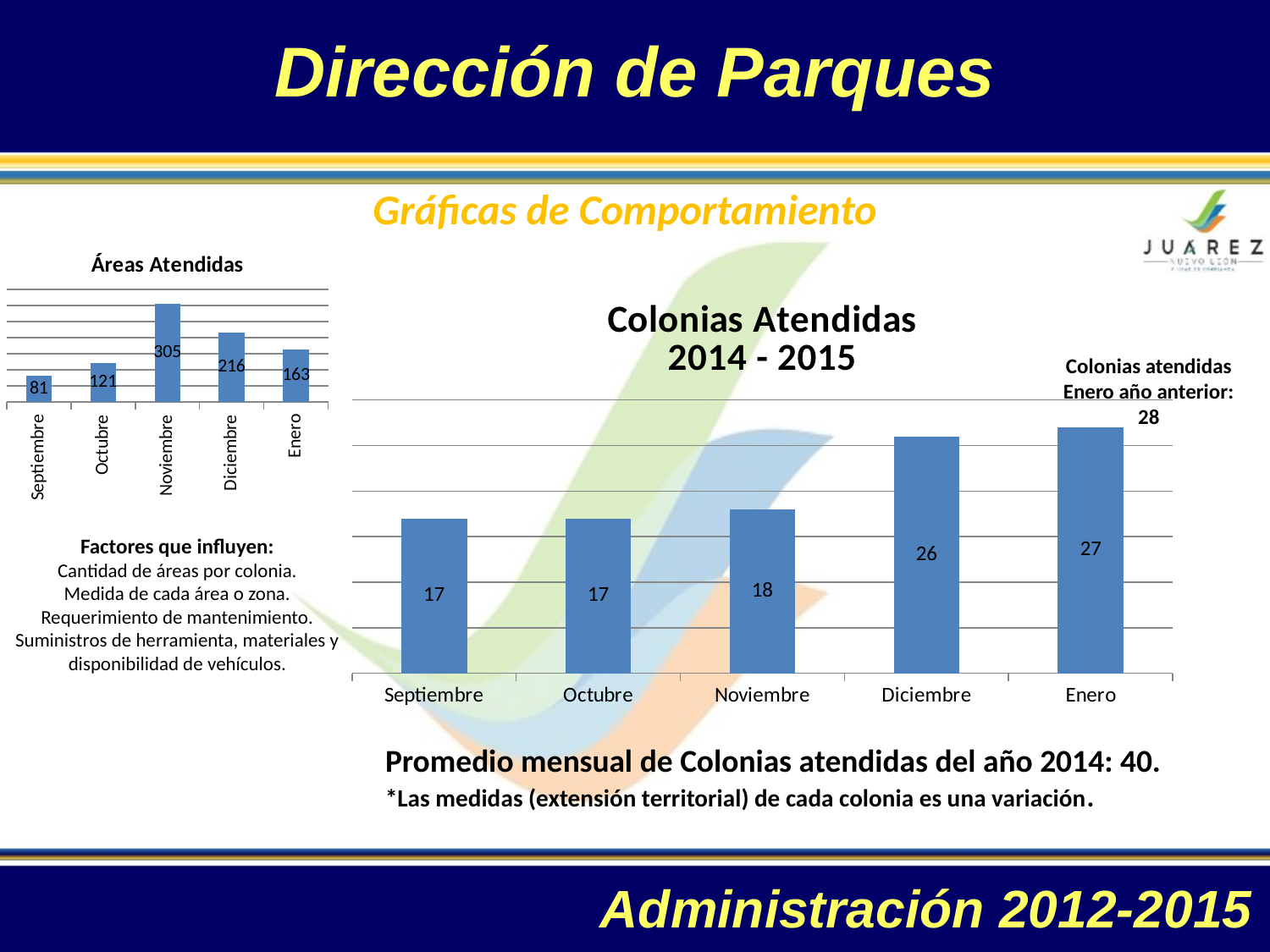
What kind of chart is 'Colonias Atendidas 2014 - 2015'? bar chart In the 'Áreas Atendidas' chart, which is larger, the value for Diciembre or the value for Enero? Diciembre In the 'Colonias Atendidas 2014 - 2015' chart, how many months are shown on the x axis? 5 In the 'Colonias Atendidas 2014 - 2015' chart, do the values generally rise or fall from Septiembre to Enero? rise In the 'Áreas Atendidas' chart, what is the value for Noviembre? 305 In the 'Colonias Atendidas 2014 - 2015' chart, what is the difference between the values for Enero and Septiembre? 10 What is the title of the larger chart on the slide? Colonias Atendidas 2014 - 2015 In the 'Colonias Atendidas 2014 - 2015' chart, what is the value for Diciembre? 26 In the 'Colonias Atendidas 2014 - 2015' chart, which month has the highest value? Enero In the 'Colonias Atendidas 2014 - 2015' chart, what is the value for Noviembre? 18 In the 'Áreas Atendidas' chart, what is the difference between the values for Noviembre and Octubre? 184 In the 'Áreas Atendidas' chart, which month has the lowest value? Septiembre